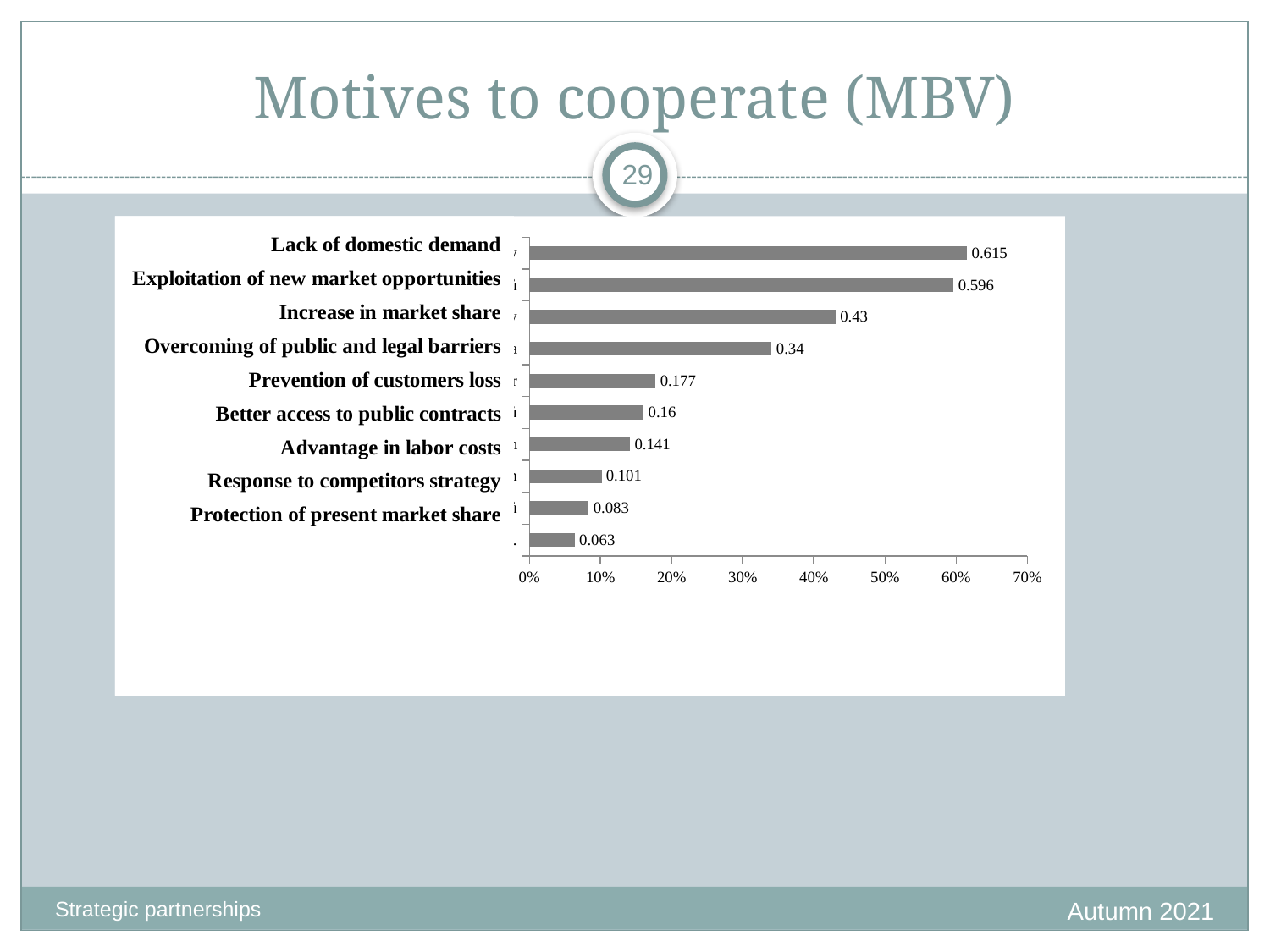
What is the smallest value labelled on any bar in the chart? 0.063 Is the value for Increase in market share greater or less than 40%? greater What is the difference between the values for Increase in market share and Overcoming of public and legal barriers? 0.09 How many bars are plotted in the chart? 10 What is the value shown for Lack of domestic demand? 0.615 What is the value shown for Protection of present market share? 0.083 Which is larger, the value for Prevention of customers loss or the value for Better access to public contracts? Prevention of customers loss What is the value shown for Overcoming of public and legal barriers? 0.34 What kind of chart is shown on the slide? bar chart What is the value shown for Advantage in labor costs? 0.141 What is the value shown for Exploitation of new market opportunities? 0.596 Which motive has the highest value in the chart? Lack of domestic demand